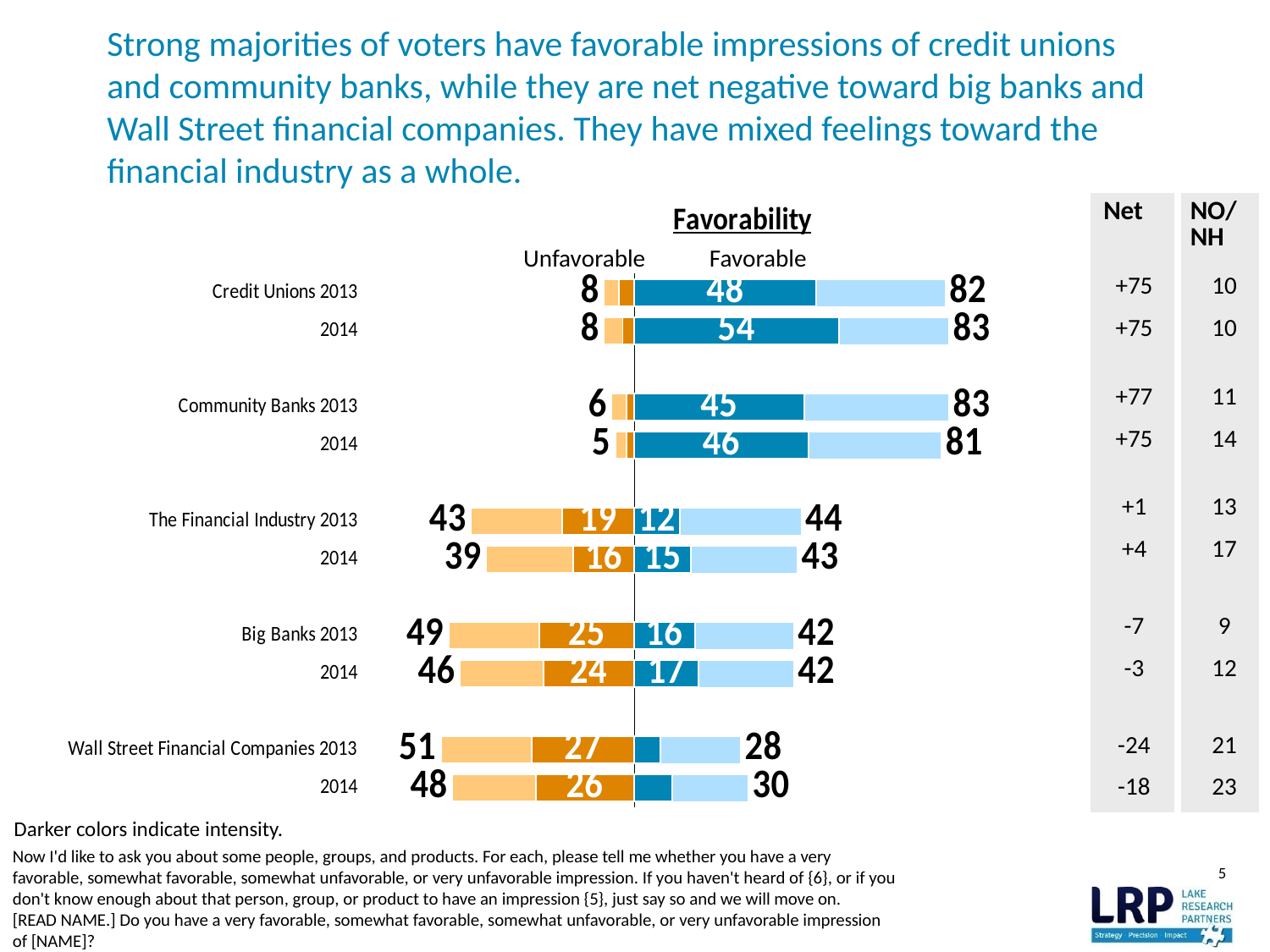
What is the very favorable (dark blue) value for Credit Unions in 2013? 48 What is the total favorable value for The Financial Industry in 2013? 44 What is the difference between the total favorable values for Credit Unions 2013 and Wall Street Financial Companies 2013? 54 What kind of chart is the Favorability chart? Bar chart Which group has the lowest total favorable value in 2013? Wall Street Financial Companies Which is larger, the total unfavorable value for Big Banks 2014 or for The Financial Industry 2014? Big Banks 2014 How many bars are plotted in the Favorability chart? 10 Which group has the highest total unfavorable value in 2014? Wall Street Financial Companies What is the very unfavorable (dark orange) value for Wall Street Financial Companies in 2014? 26 What is the title of the chart? Favorability What is the total favorable value for Credit Unions in 2014? 83 What is the total unfavorable value for Big Banks in 2013? 49